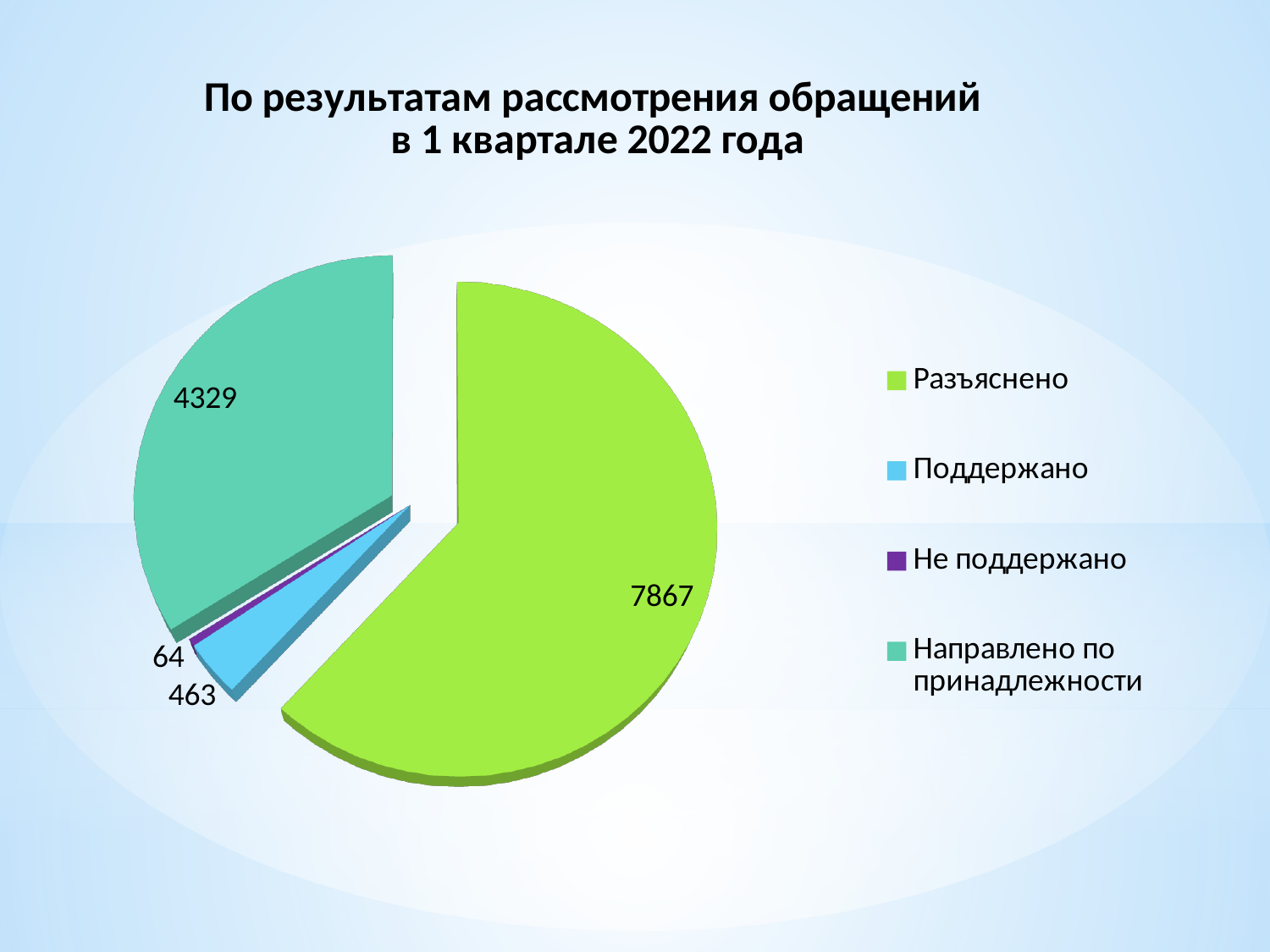
What is the difference between the values for Разъяснено and Направлено по принадлежности? 3538 Which category has the largest slice of the pie? Разъяснено What is the value for Разъяснено? 7867 What is the total of all the values shown in the pie chart? 12723 How many slices does the pie chart have? 4 What kind of chart is shown on the slide? Pie chart Which category has the smallest slice of the pie? Не поддержано What is the value for Направлено по принадлежности? 4329 What is the value for Поддержано? 463 Which is larger, Поддержано or Не поддержано? Поддержано What is the value for Не поддержано? 64 What is the title of the chart? По результатам рассмотрения обращений в 1 квартале 2022 года